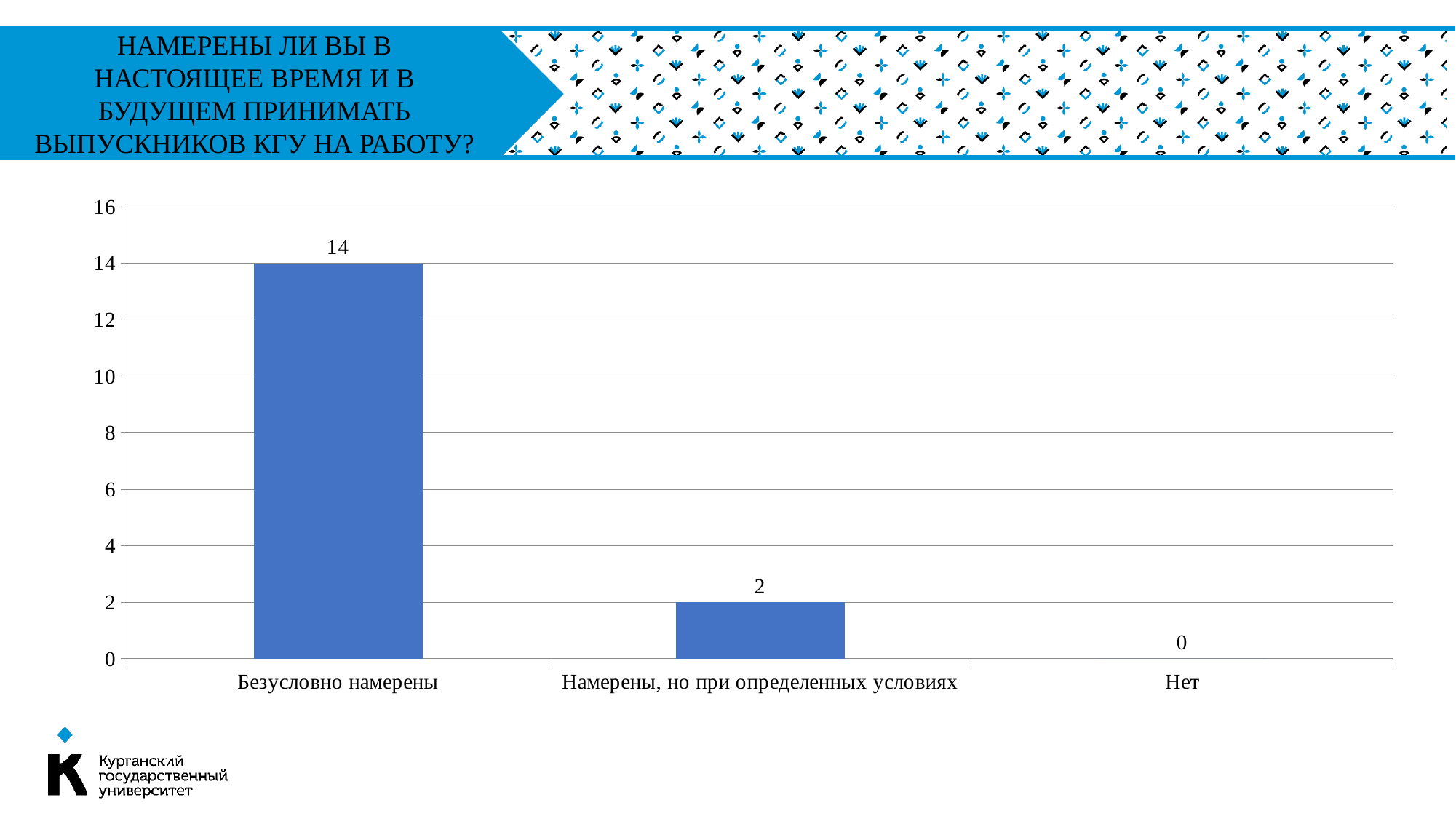
What is the difference between the values for "Безусловно намерены" and "Намерены, но при определенных условиях"? 12 What kind of chart is shown on the slide? bar chart What is the maximum value shown on the vertical axis? 16 Do the values rise or fall from left to right along the x axis? fall Which category has the highest value? Безусловно намерены Which is larger: the value for "Намерены, но при определенных условиях" or the value for "Нет"? Намерены, но при определенных условиях What is the value for "Безусловно намерены"? 14 Which category has the lowest value? Нет What is the value for "Нет"? 0 Is the value for "Безусловно намерены" greater or less than 10? greater What is the value for "Намерены, но при определенных условиях"? 2 How many categories are shown on the x axis? 3